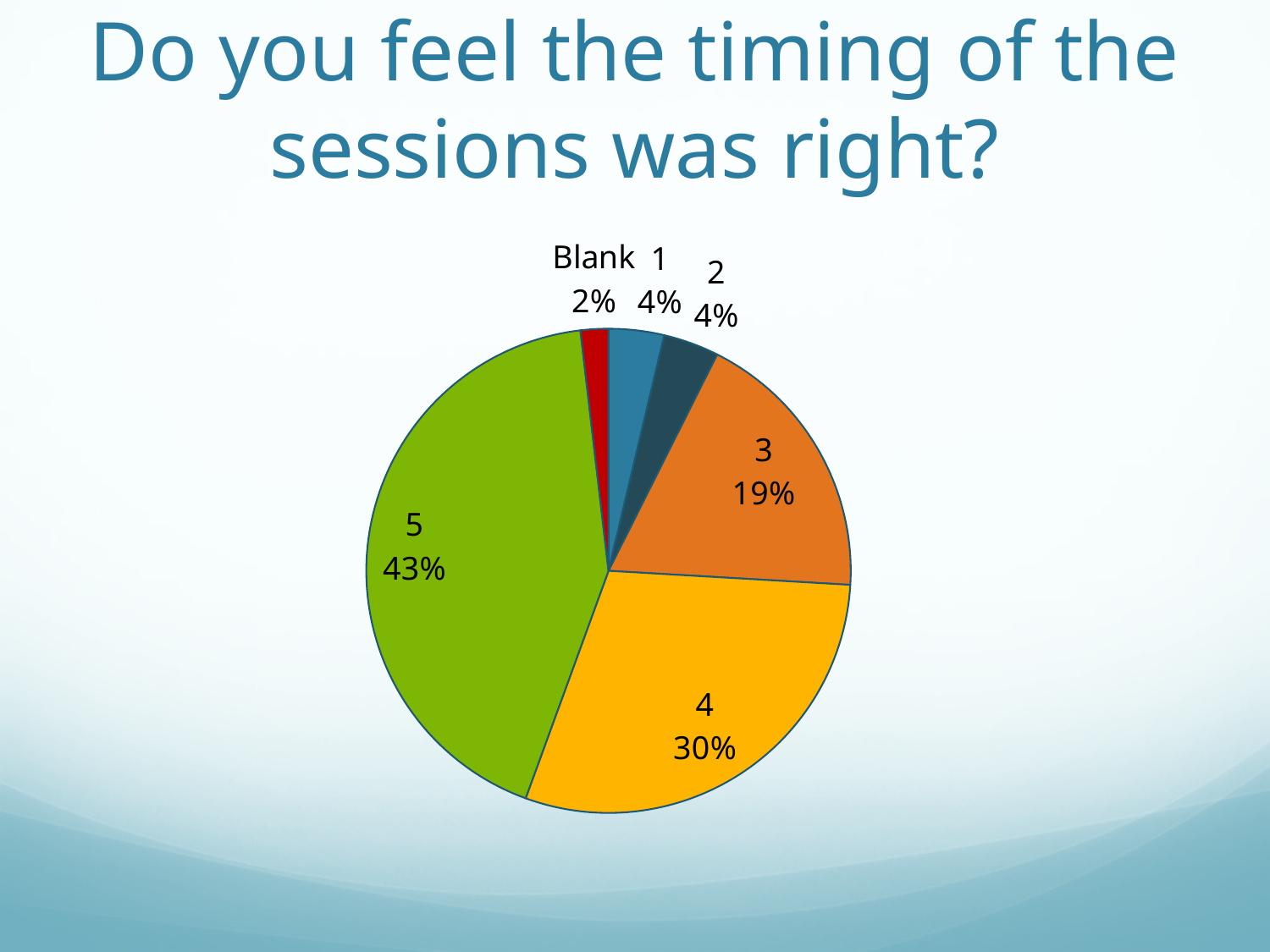
Which slice of the pie is the smallest? Blank What share of the pie does the slice labelled 4 represent? 30% How many slices does the pie chart have? 6 What share of the pie does the slice labelled 5 represent? 43% Which slice of the pie is the largest? 5 What is the difference in percentage points between the slices labelled 5 and 4? 13% What share of the pie does the slice labelled 3 represent? 19% What is the combined share of the slices labelled 4 and 5? 73% What kind of chart is shown on the slide? pie chart What is the title of the slide containing the pie chart? Do you feel the timing of the sessions was right? Which slice is larger, the one labelled 3 or the one labelled 4? 4